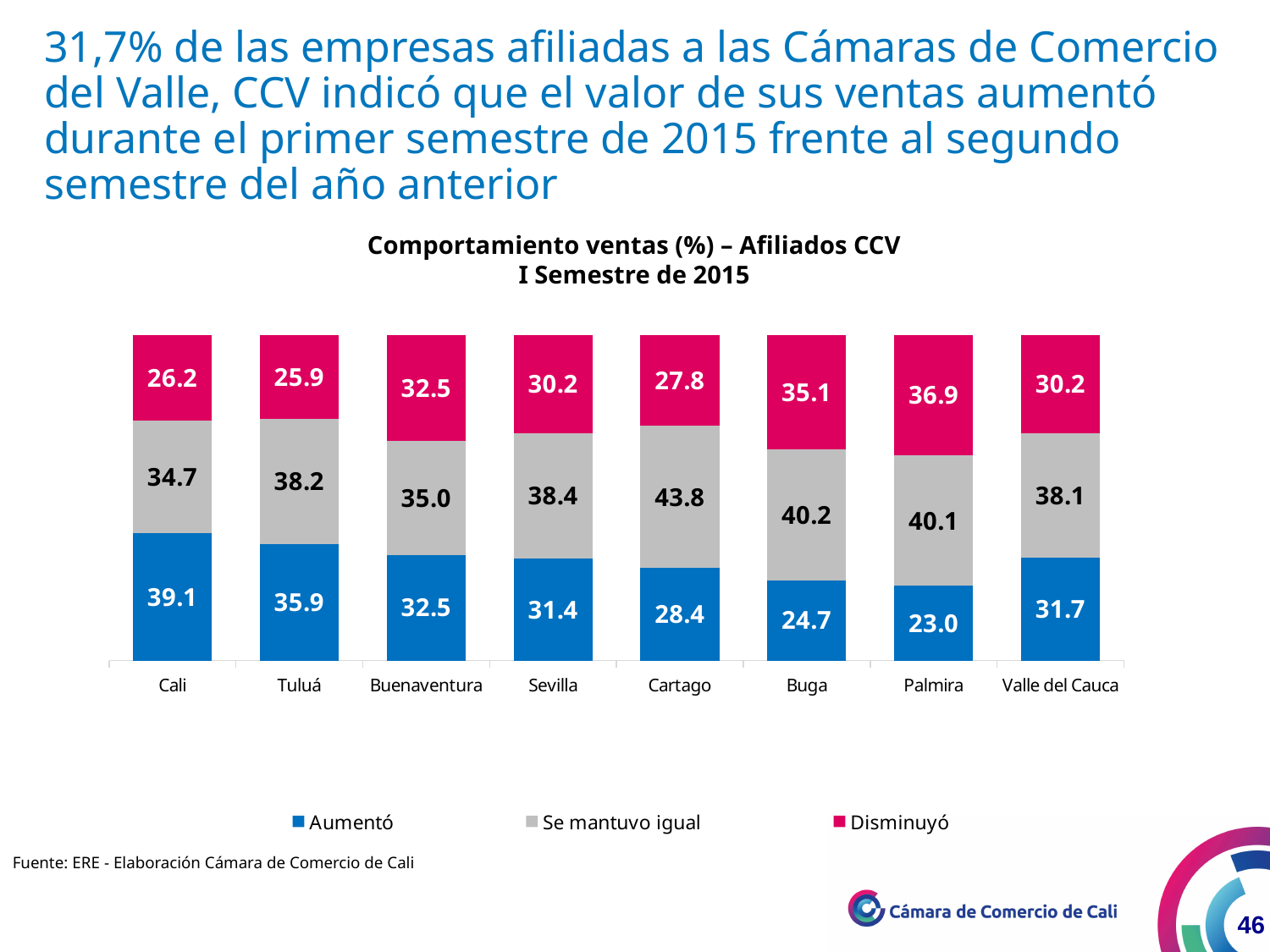
What kind of chart is shown on the slide? Stacked bar chart Which category has the lowest value for "Aumentó"? Palmira What is the difference between the "Aumentó" values for Cali and Palmira? 16.1 What is the value of "Aumentó" for Cali? 39.1 How many categories are shown on the x axis? 8 How many series does the legend list? 3 Which is larger: the "Disminuyó" value for Buga or for Sevilla? Buga What is the value of "Se mantuvo igual" for Cartago? 43.8 What is the value of "Disminuyó" for Palmira? 36.9 Which category has the highest value for "Se mantuvo igual"? Cartago Which category has the highest value for "Aumentó"? Cali What is the value of "Aumentó" for Valle del Cauca? 31.7